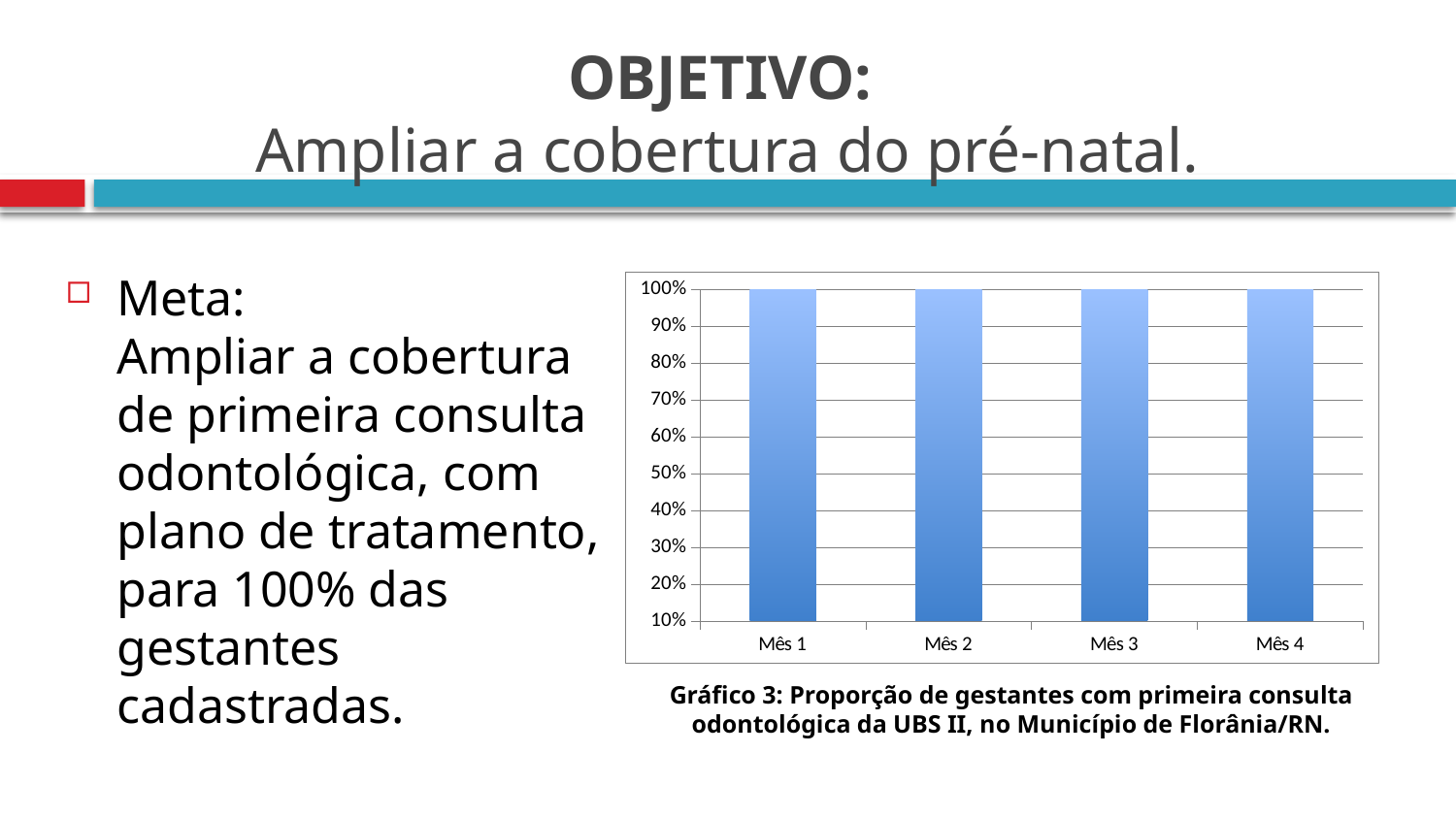
What is the value for Mês 4 in the chart? 100% What is the value for Mês 3 in the chart? 100% Do the values rise, fall, or stay the same from Mês 1 to Mês 4? stay the same How many categories (months) are shown on the x axis of the chart? 4 What is the difference between the values for Mês 1 and Mês 4? 0% What is the value for Mês 2 in the chart? 100% What type of chart is shown on the slide? bar chart Is the value for Mês 4 greater or less than 90%? greater Is the value for Mês 2 greater or less than 50%? greater What is the caption (title) given for the chart below it? Gráfico 3: Proporção de gestantes com primeira consulta odontológica da UBS II, no Município de Florânia/RN. What is the lowest value shown on the y axis of the chart? 10% What is the value for Mês 1 in the chart? 100%